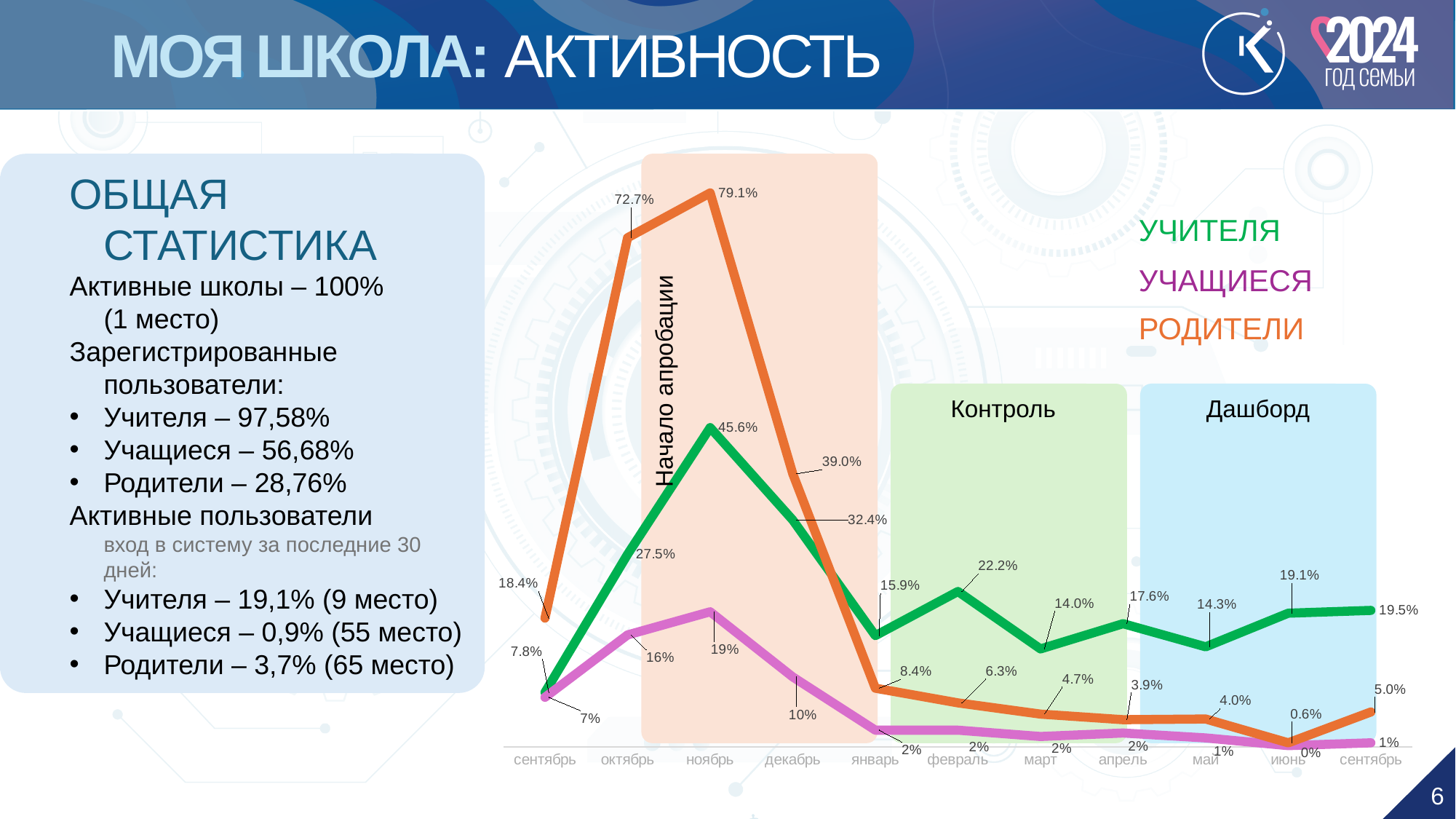
How many series does the chart's legend list? 3 How many points (months) are plotted along the x axis of the chart? 11 What is the difference between the РОДИТЕЛИ values in ноябрь and октябрь? 6.4 percentage points What is the value for УЧАЩИЕСЯ in ноябрь? 19% What is the value for УЧИТЕЛЯ in ноябрь? 45.6% In which month does the РОДИТЕЛИ series reach its highest value? ноябрь Does the РОДИТЕЛИ series rise or fall from ноябрь to июнь? Fall What kind of chart is shown on the slide? Line chart What colour is used for the РОДИТЕЛИ series in the chart? Orange In which month does the РОДИТЕЛИ series reach its lowest value? июнь What is the value for РОДИТЕЛИ in ноябрь? 79.1% In декабрь, which is larger: the value for РОДИТЕЛИ or for УЧИТЕЛЯ? РОДИТЕЛИ